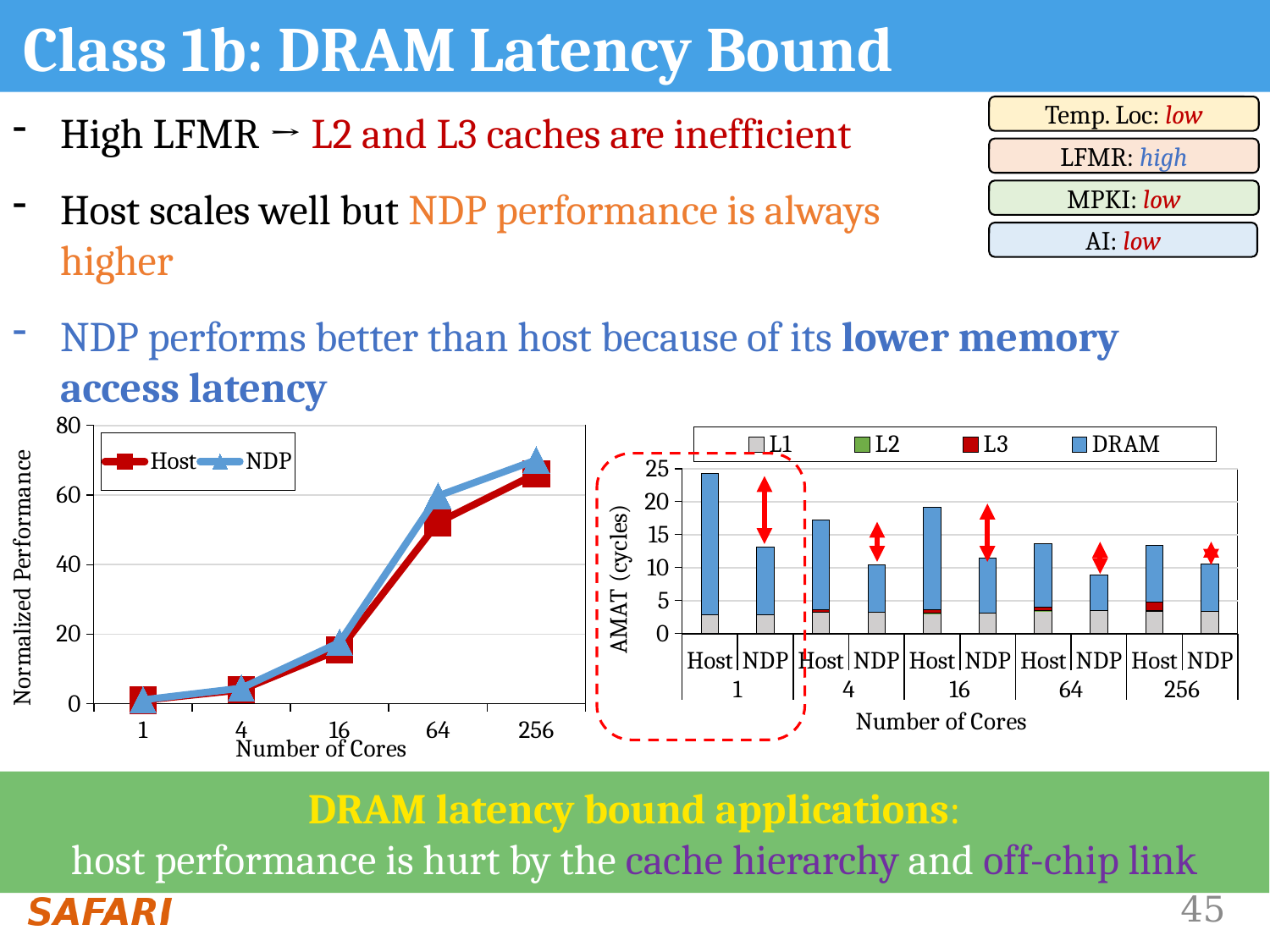
In the right AMAT chart, which bar has the highest total AMAT? Host at 1 core In the left Normalized Performance chart, how many core counts are plotted on the x axis? 5 What kind of chart is the right chart showing AMAT (cycles)? bar chart In the right AMAT chart, how many bars are plotted in total? 10 In the left Normalized Performance chart, how many series does the legend list? 2 In the right AMAT chart, is the total AMAT for Host at 1 core greater or less than 20? greater In the left Normalized Performance chart, is the Host value at 64 cores greater or less than 40? greater What kind of chart is the left chart showing Normalized Performance versus Number of Cores? line chart In the left Normalized Performance chart, does the NDP series rise or fall as the number of cores increases? rise In the right AMAT chart, how many series does the legend list? 4 In the right AMAT chart, which legend entry is shown in red? L3 In the left Normalized Performance chart, which series has the higher value at 64 cores, Host or NDP? NDP